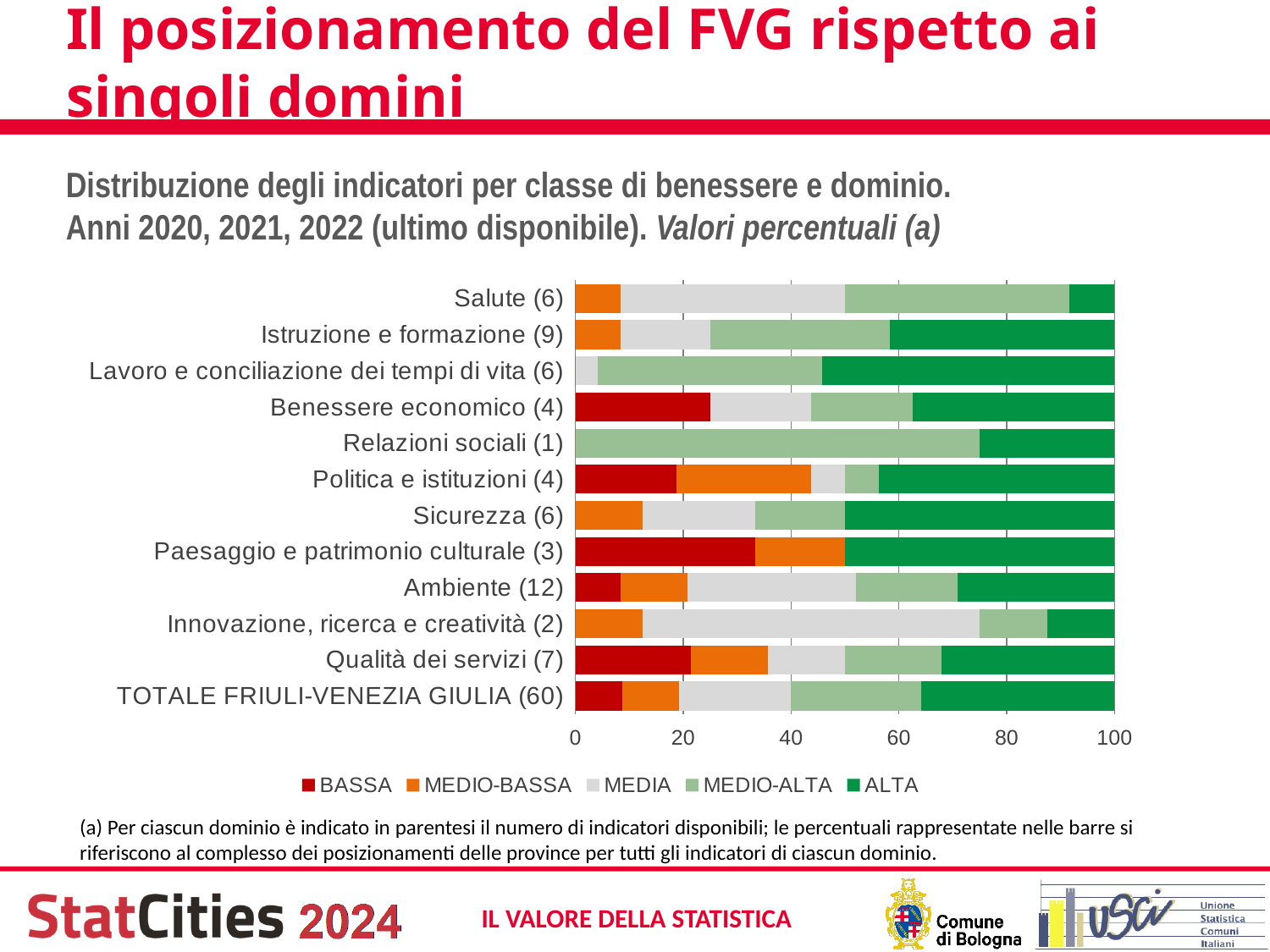
Which has the larger ALTA segment, Lavoro e conciliazione dei tempi di vita (6) or Salute (6)? Lavoro e conciliazione dei tempi di vita (6) Is the MEDIO-ALTA value for Relazioni sociali (1) greater or less than 60? greater How many series does the legend list? 5 Is the ALTA value for Salute (6) greater or less than 20? less Which series are listed in the legend? BASSA, MEDIO-BASSA, MEDIA, MEDIO-ALTA, ALTA Is the BASSA value for Paesaggio e patrimonio culturale (3) greater or less than 20? greater Which has the larger BASSA segment, Benessere economico (4) or Ambiente (12)? Benessere economico (4) How many domain categories (bars) are plotted in the chart? 12 What value does each stacked bar reach on the x axis? 100 Which category has the largest BASSA segment? Paesaggio e patrimonio culturale (3) What kind of chart is shown on the slide? Stacked bar chart